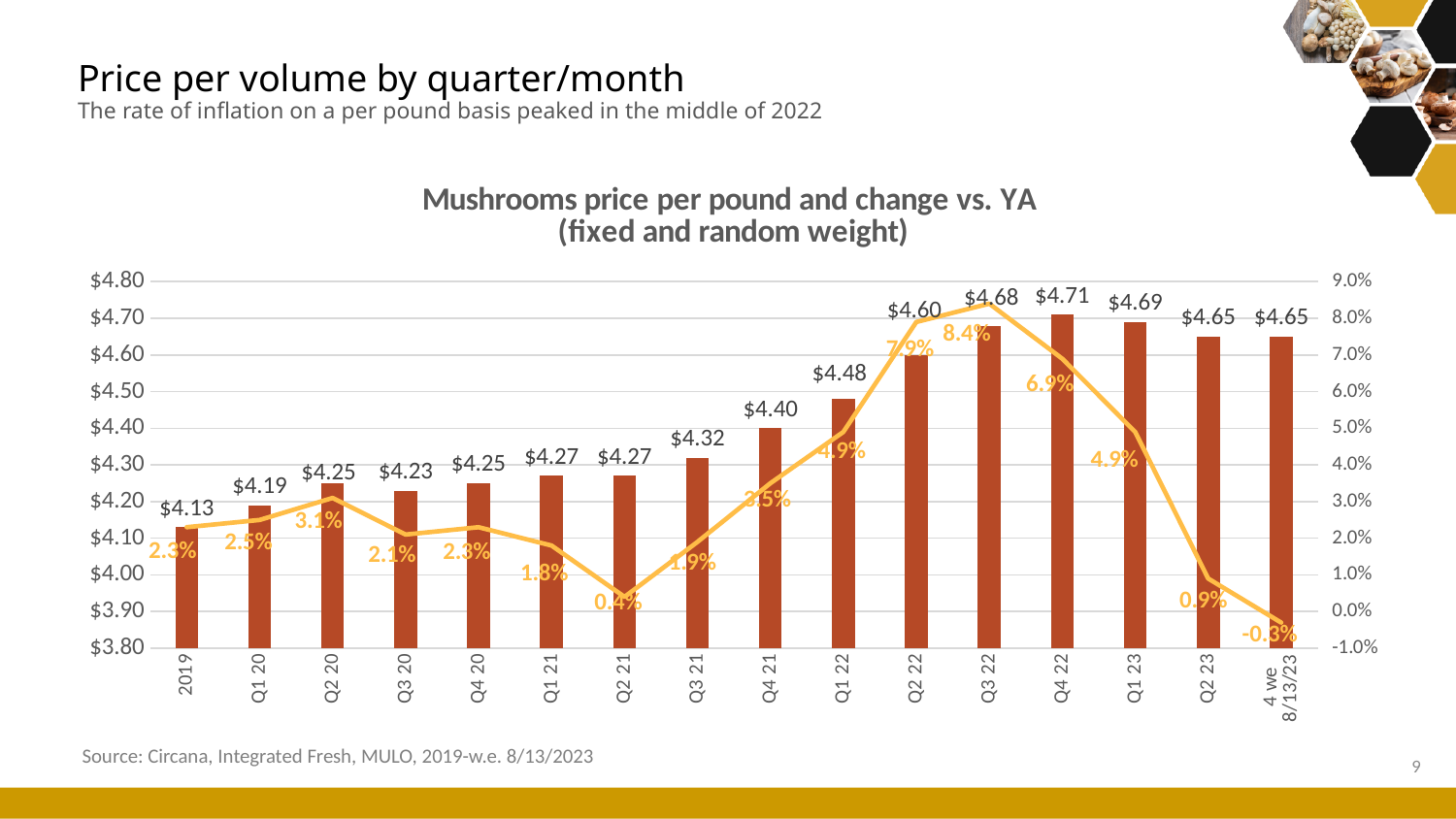
What is the difference between the price per pound in Q4 22 and in 2019? $0.58 What is the mushrooms price per pound for 2019? $4.13 What is the change vs. YA shown for Q3 22? 8.4% Which period has the highest price per pound? Q4 22 What kind of chart is this? Combination bar and line chart Does the price per pound rise or fall from 2019 to Q4 22? Rise How many periods are shown on the x axis? 16 Which period has the lowest price per pound? 2019 What is the change vs. YA shown for Q2 21? 0.4% Which has the higher price per pound, Q2 22 or Q3 22? Q3 22 What is the mushrooms price per pound for Q4 22? $4.71 What is the change vs. YA shown for the 4 we 8/13/23 period? -0.3%